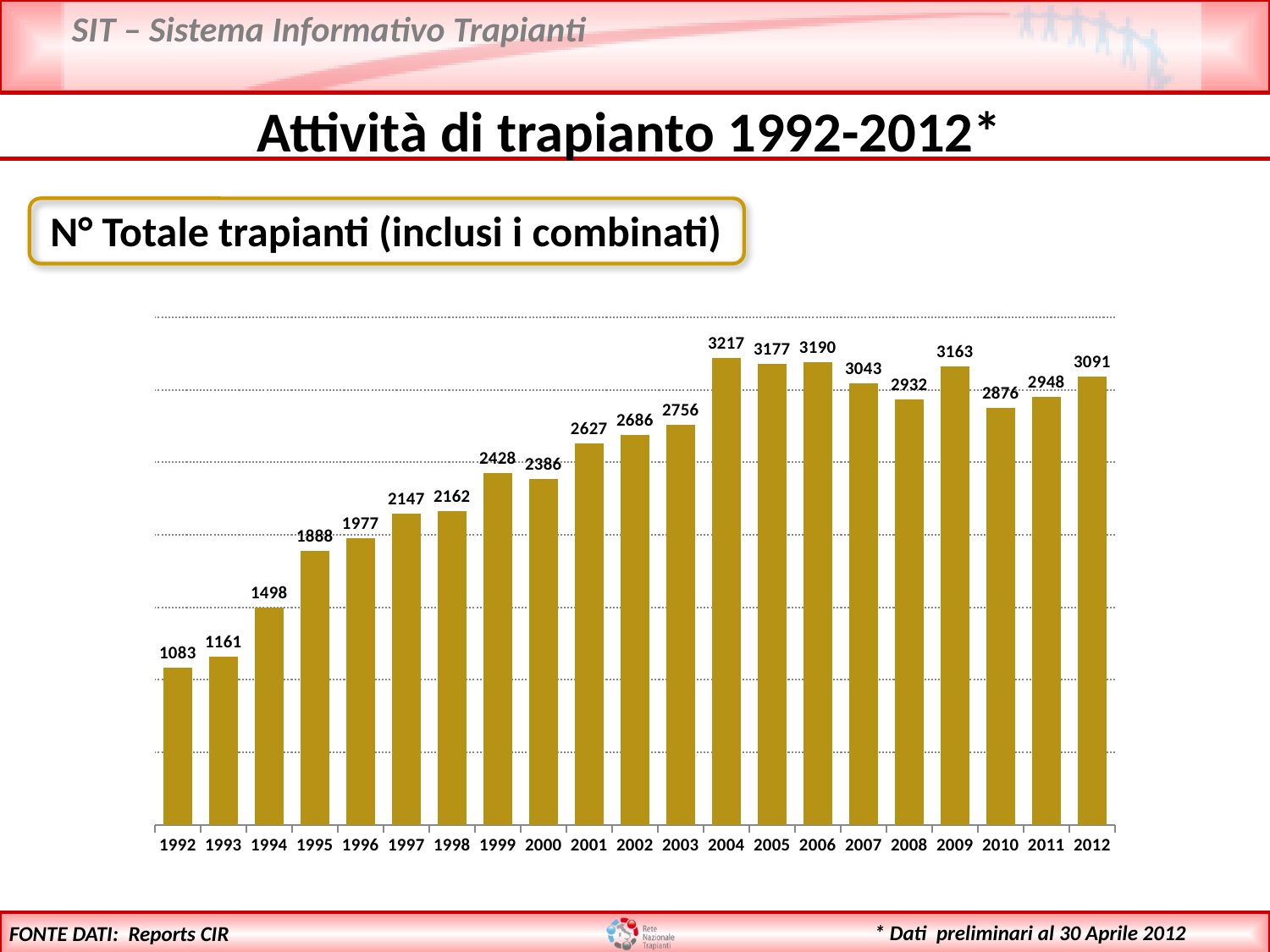
Which is larger, the value for 2009 or the value for 2010? 2009 How many years are shown on the x axis? 21 What is the difference between the values for 2004 and 2012? 126 What is the value for 2012? 3091 Which year has the lowest value? 1992 What is the value for 2004? 3217 What is the value for 1992? 1083 What kind of chart is shown on the slide? Bar chart Do the values generally rise or fall from 1992 to 2004? Rise What is the value for 2000? 2386 Which year has the highest value? 2004 What is the difference between the values for 1994 and 1993? 337